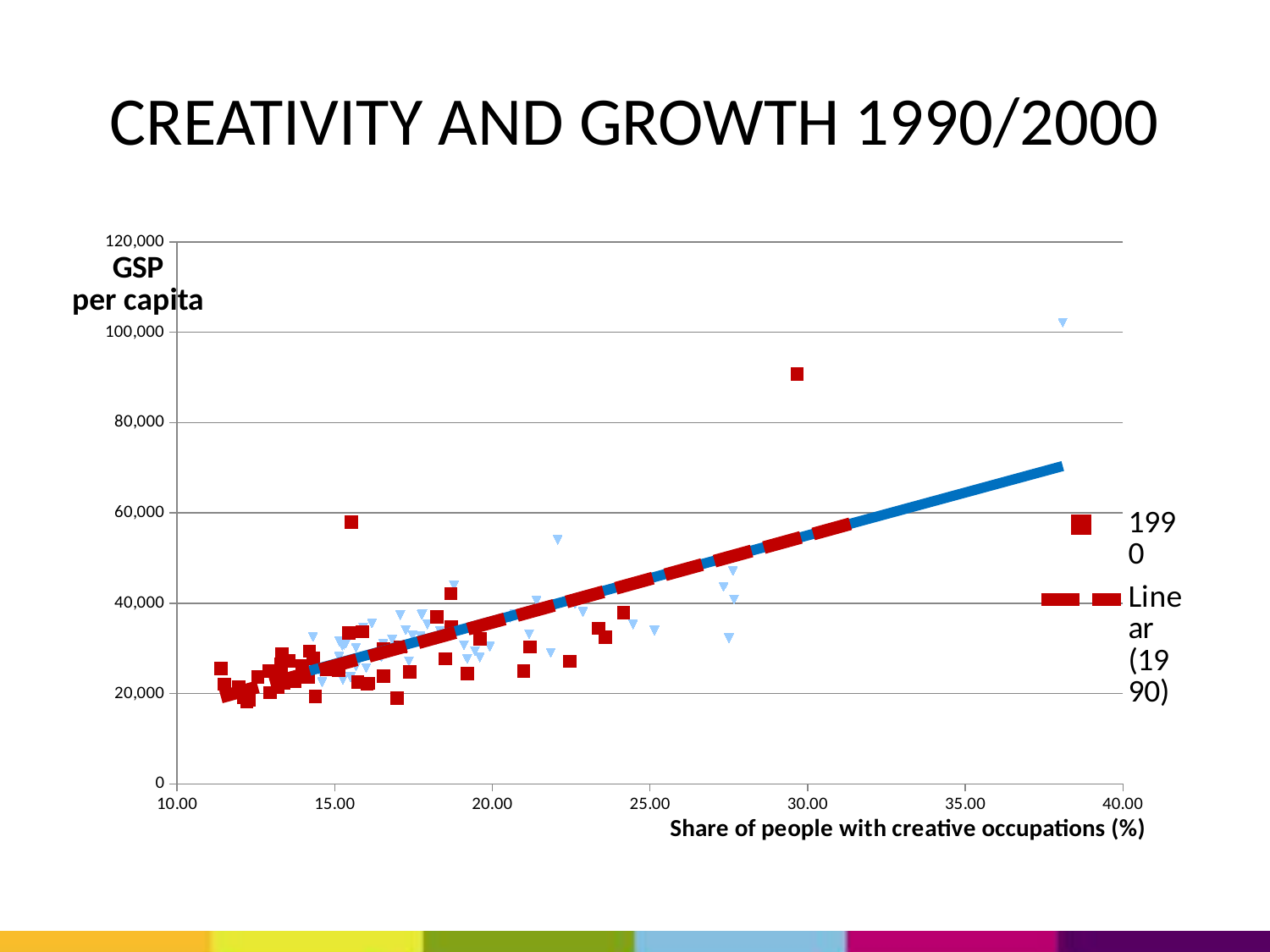
What is the title of the chart on the slide? CREATIVITY AND GROWTH 1990/2000 Does the linear trend line for 1990 rise or fall as the share of people with creative occupations increases? Rises Is the value of the 1990 linear trend line at a 15.00% share of creative occupations greater or less than 40,000? less What kind of chart is shown on the slide? Scatter chart Is the value of the 1990 linear trend line at a 30.00% share of creative occupations greater or less than 40,000? greater What is the label of the horizontal axis of the chart? Share of people with creative occupations (%) Is the lowest GSP per capita value among the 1990 data points greater or less than 20,000? less How many entries does the chart's legend list? 2